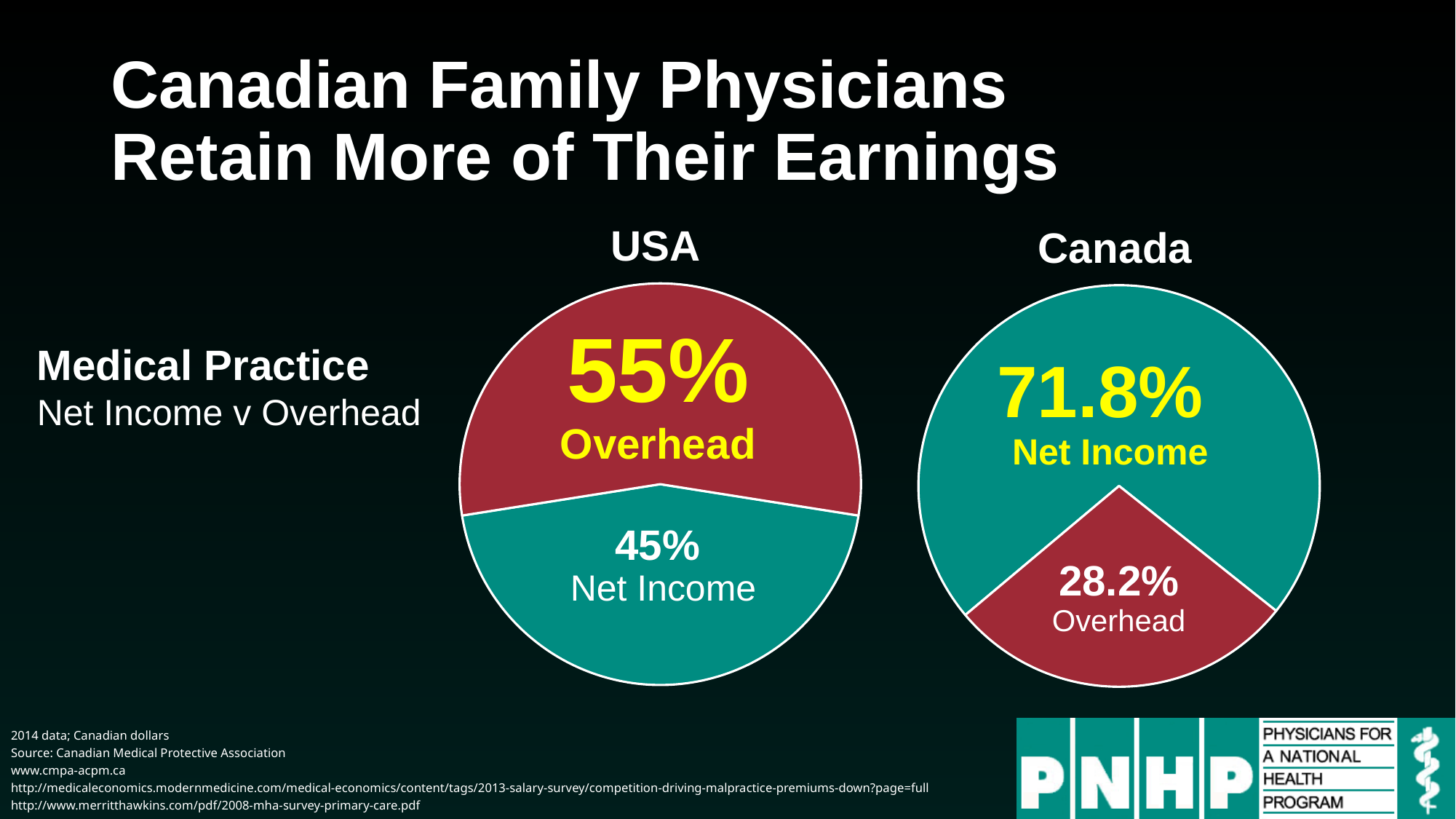
In the Canada pie chart, which slice is the smallest? Overhead In the Canada pie chart, what share is Net Income? 71.8% In the USA pie chart, which slice is larger, Overhead or Net Income? Overhead In the USA pie chart, what share is Overhead? 55% What is the difference between the Net Income share in the Canada pie chart and the Net Income share in the USA pie chart? 26.8% In the Canada pie chart, what share is Overhead? 28.2% In the USA pie chart, what share is Net Income? 45% In the USA pie chart, what is the difference between the Overhead share and the Net Income share? 10% What colour is the Net Income slice in the USA pie chart? Teal What kind of chart is used to show the USA and Canada data? Pie chart In the Canada pie chart, which slice is the largest? Net Income How many slices does the Canada pie chart have? 2